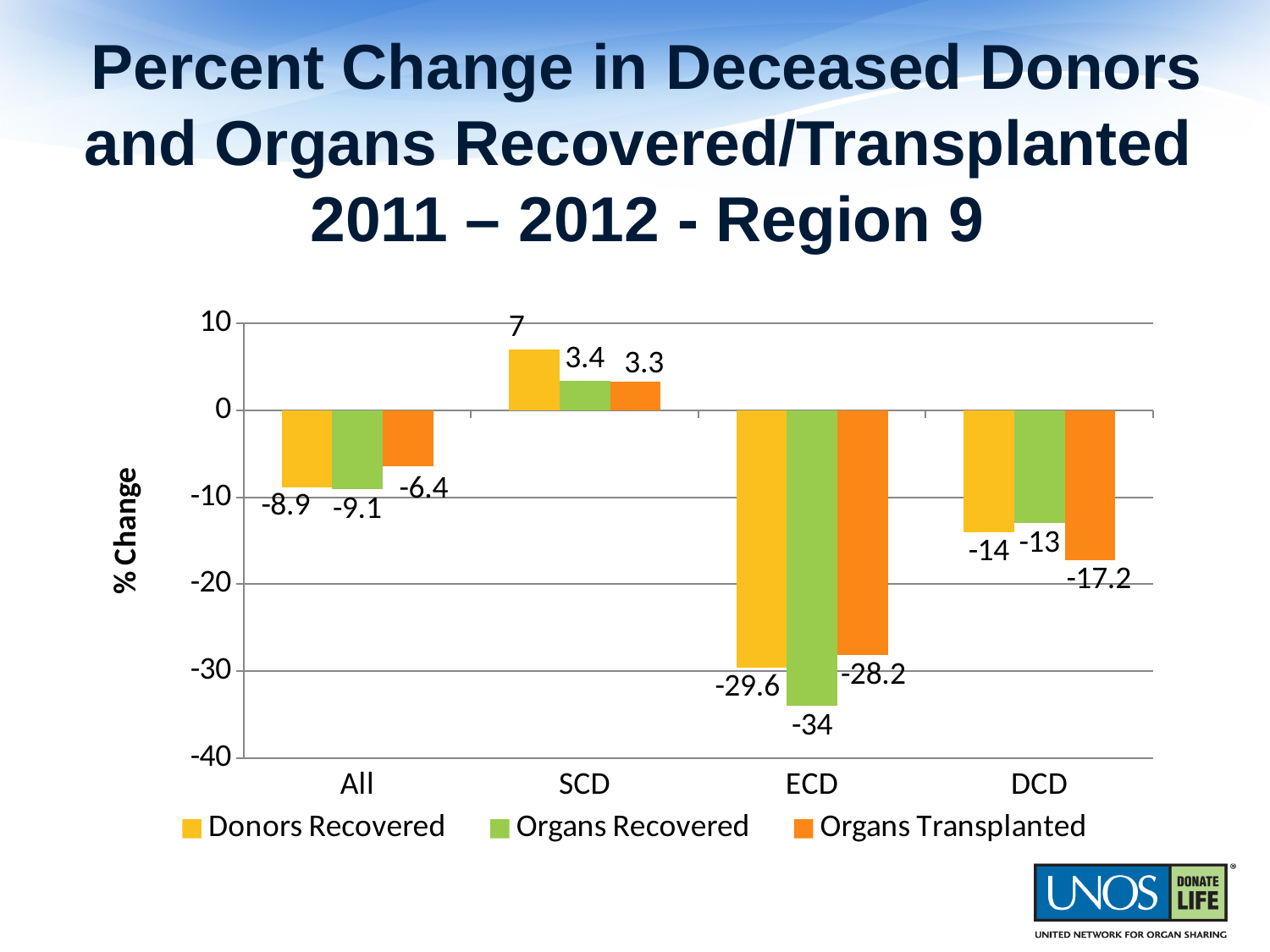
How many categories are shown on the x axis? 4 What is the label on the vertical axis? % Change What is the Organs Transplanted value for All? -6.4 What is the Organs Recovered value for DCD? -13 Which category has the lowest Organs Recovered value? ECD What kind of chart is shown on the slide? Bar chart Which is larger, the Organs Transplanted value for DCD or the Organs Transplanted value for All? All What is the Donors Recovered value for SCD? 7 What is the Organs Transplanted value for ECD? -28.2 What is the difference between the Donors Recovered value for ECD and the Donors Recovered value for DCD? 15.6 Which category has the highest Donors Recovered value? SCD How many series does the legend list? 3